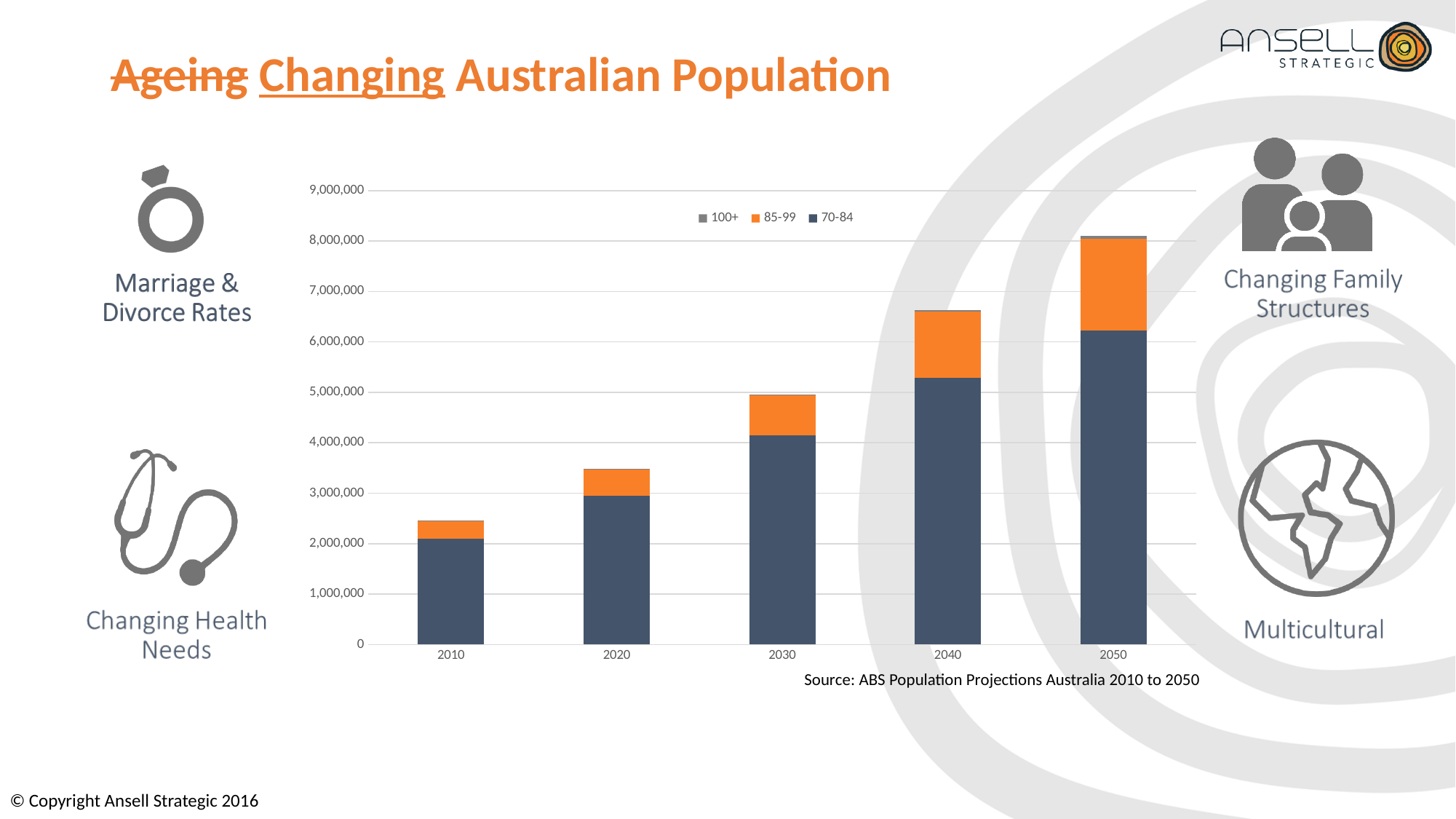
How many years are shown along the x axis of the chart? 5 How many series does the chart's legend list? 3 Is the total stacked bar for 2010 greater or less than 3,000,000? less Which is larger in 2050, the 70-84 segment or the 85-99 segment? 70-84 Which year has the shortest stacked bar in the chart? 2010 What kind of chart is shown on the slide? Stacked bar chart Which age group is shown in orange in the chart's legend? 85-99 Which year has the tallest stacked bar in the chart? 2050 Do the stacked bar totals rise or fall from 2010 to 2050? Rise Is the total stacked bar for 2040 greater or less than 6,000,000? greater Is the 70-84 segment for 2030 greater or less than 4,000,000? greater What source is cited below the chart? ABS Population Projections Australia 2010 to 2050